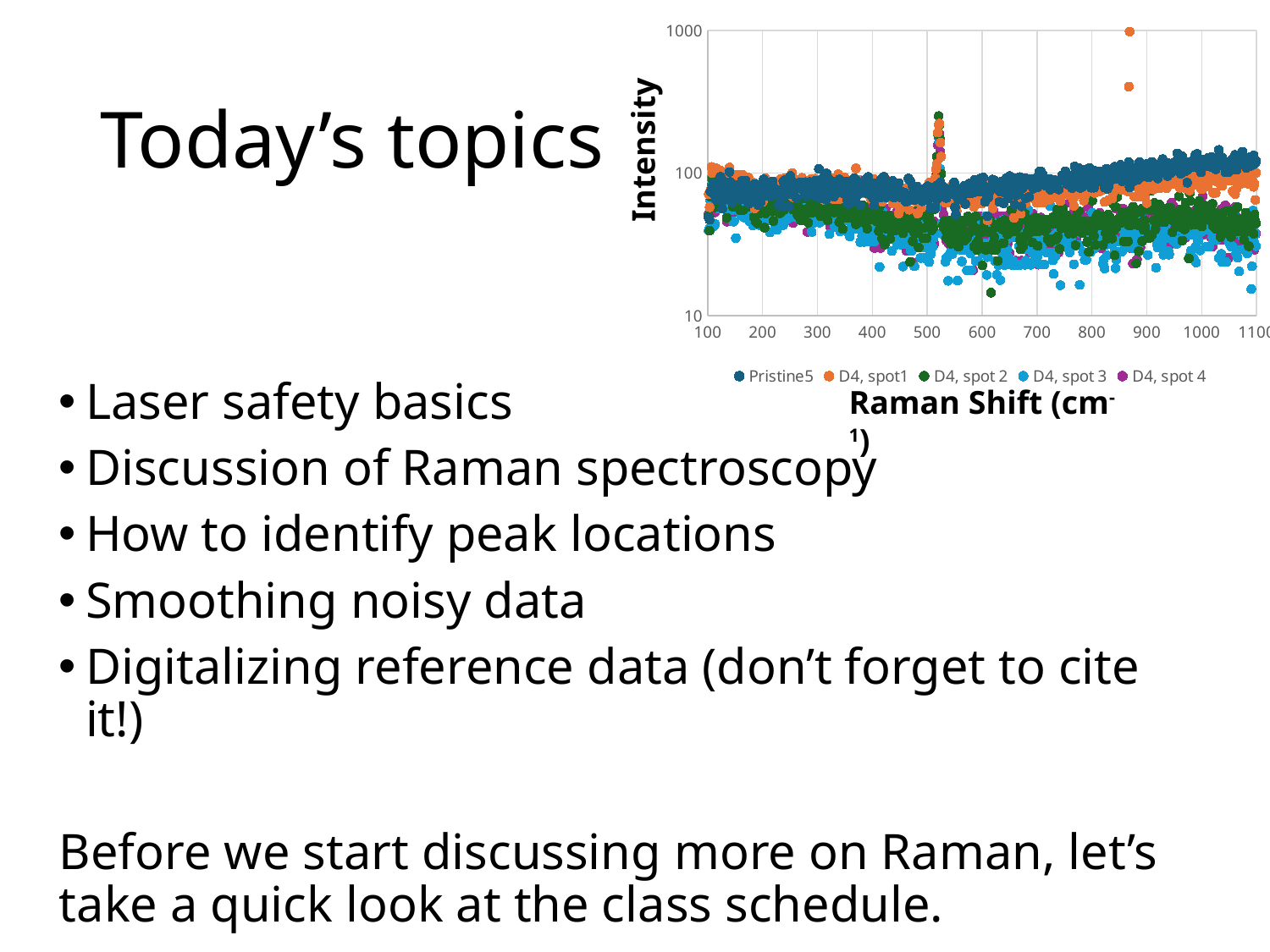
Does the intensity of the Pristine5 series rise or fall as the Raman shift increases from 100 to 1100? rise Near a Raman shift of 1000, which series has higher intensity: Pristine5 or D4, spot 3? Pristine5 Is the intensity of the sharp peak near a Raman shift of 520 greater or less than 100? greater What is the title of the chart's y axis? Intensity Is the intensity of the D4, spot 3 series near a Raman shift of 1100 greater or less than 100? less Which series is listed first in the chart's legend? Pristine5 Which series has the highest single point on the chart? D4, spot1 How many series does the chart's legend list? 5 Is the intensity of the Pristine5 series near a Raman shift of 1000 greater or less than 100? greater What kind of chart is shown on the slide? scatter chart